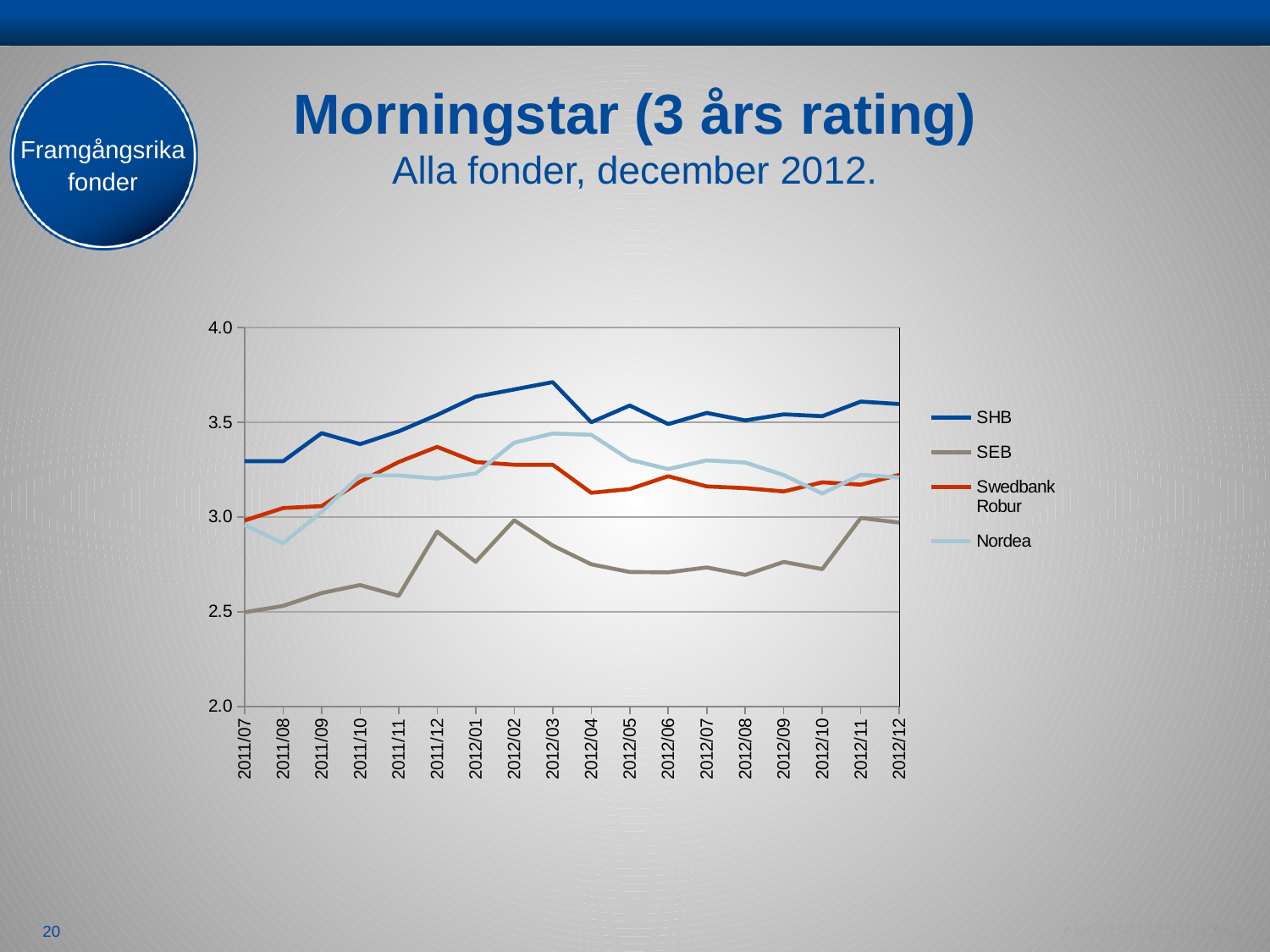
Is the value for SHB in 2012/03 greater or less than 3.5? greater Is the value for SEB in 2012/03 greater or less than 3.0? less In 2012/03, which is larger: Nordea or Swedbank Robur? Nordea Is the value for Nordea in 2011/08 greater or less than 3.0? less Which series has the highest rating across the whole period? SHB How many months are shown along the x axis? 18 What kind of chart is shown on the slide? Line chart Which series has the lowest rating across the whole period? SEB What is the title of the chart on the slide? Morningstar (3 års rating) Does the SHB line rise or fall from 2011/07 to 2012/03? rise How many series does the legend list? 4